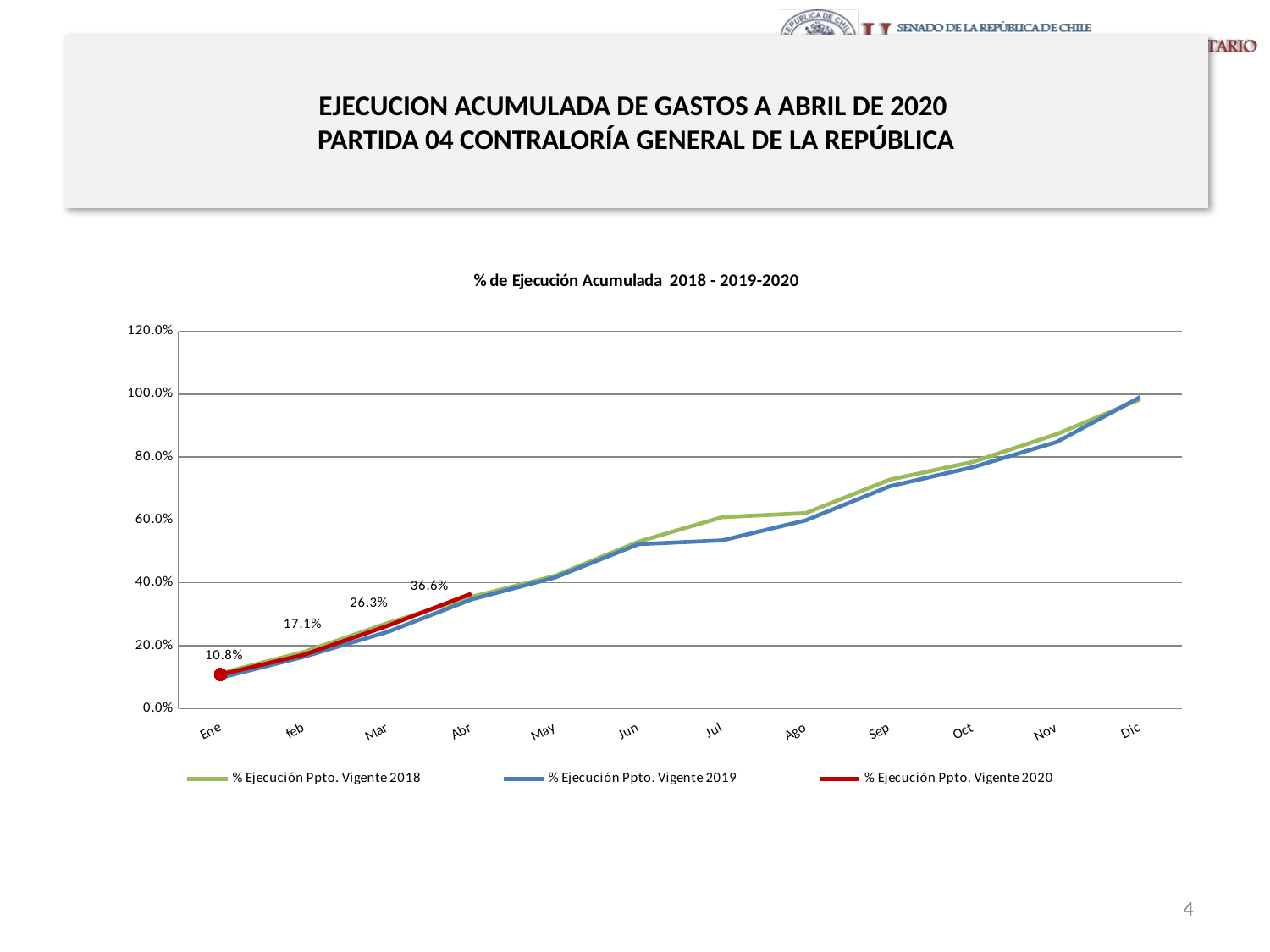
Does the % Ejecución Ppto. Vigente 2020 line rise or fall from Ene to Abr? rise How many series does the legend list? 3 How many months are shown on the x axis? 12 Is the value for % Ejecución Ppto. Vigente 2018 in Sep greater or less than 60%? greater What is the value of % Ejecución Ppto. Vigente 2020 in Abr? 36.6% What is the value of % Ejecución Ppto. Vigente 2020 in Ene? 10.8% What is the value of % Ejecución Ppto. Vigente 2020 in Mar? 26.3% What kind of chart is shown on the slide? line chart What is the title of the chart? % de Ejecución Acumulada 2018 - 2019-2020 What is the difference between the 2020 values for Abr and Ene? 25.8% In Jul, which series has the higher value: % Ejecución Ppto. Vigente 2018 or % Ejecución Ppto. Vigente 2019? % Ejecución Ppto. Vigente 2018 Is the value for % Ejecución Ppto. Vigente 2019 in Jul greater or less than 60%? less